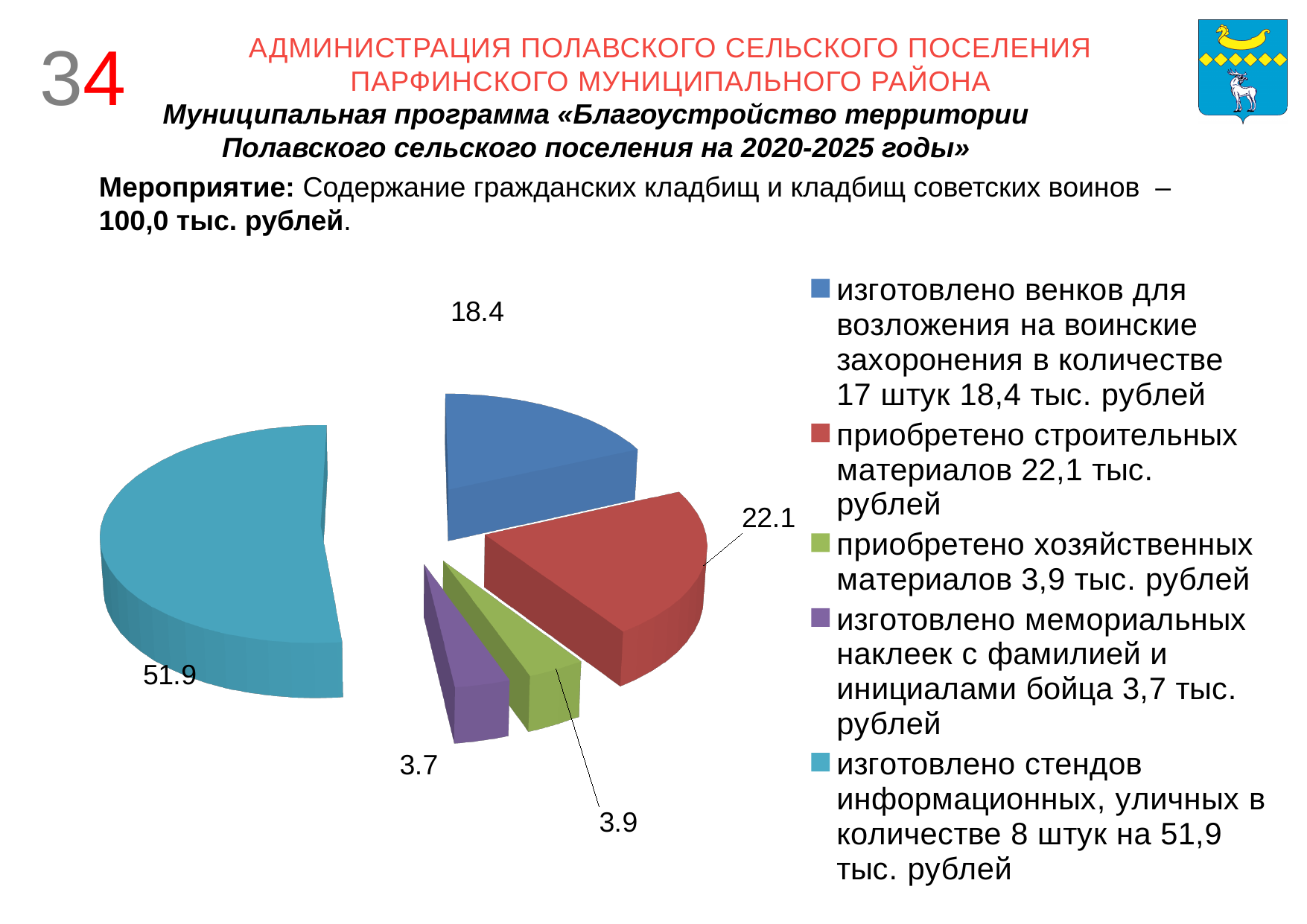
Which category has the largest slice of the pie chart? изготовлено стендов информационных, уличных Which is larger: the value for «приобретено строительных материалов» or the value for «изготовлено венков для возложения на воинские захоронения»? приобретено строительных материалов What type of chart is shown on the slide? pie chart How many slices does the pie chart have? 5 What value is shown for the slice «приобретено строительных материалов»? 22.1 What value is shown for the slice «изготовлено венков для возложения на воинские захоронения»? 18.4 What is the difference between the values for «приобретено строительных материалов» and «изготовлено венков для возложения на воинские захоронения»? 3.7 What value is shown for the slice «изготовлено мемориальных наклеек с фамилией и инициалами бойца»? 3.7 How many entries does the legend of the pie chart list? 5 What value is shown for the slice «приобретено хозяйственных материалов»? 3.9 Which category has the smallest slice of the pie chart? изготовлено мемориальных наклеек с фамилией и инициалами бойца What colour is the slice for «изготовлено стендов информационных, уличных»? cyan (light blue)